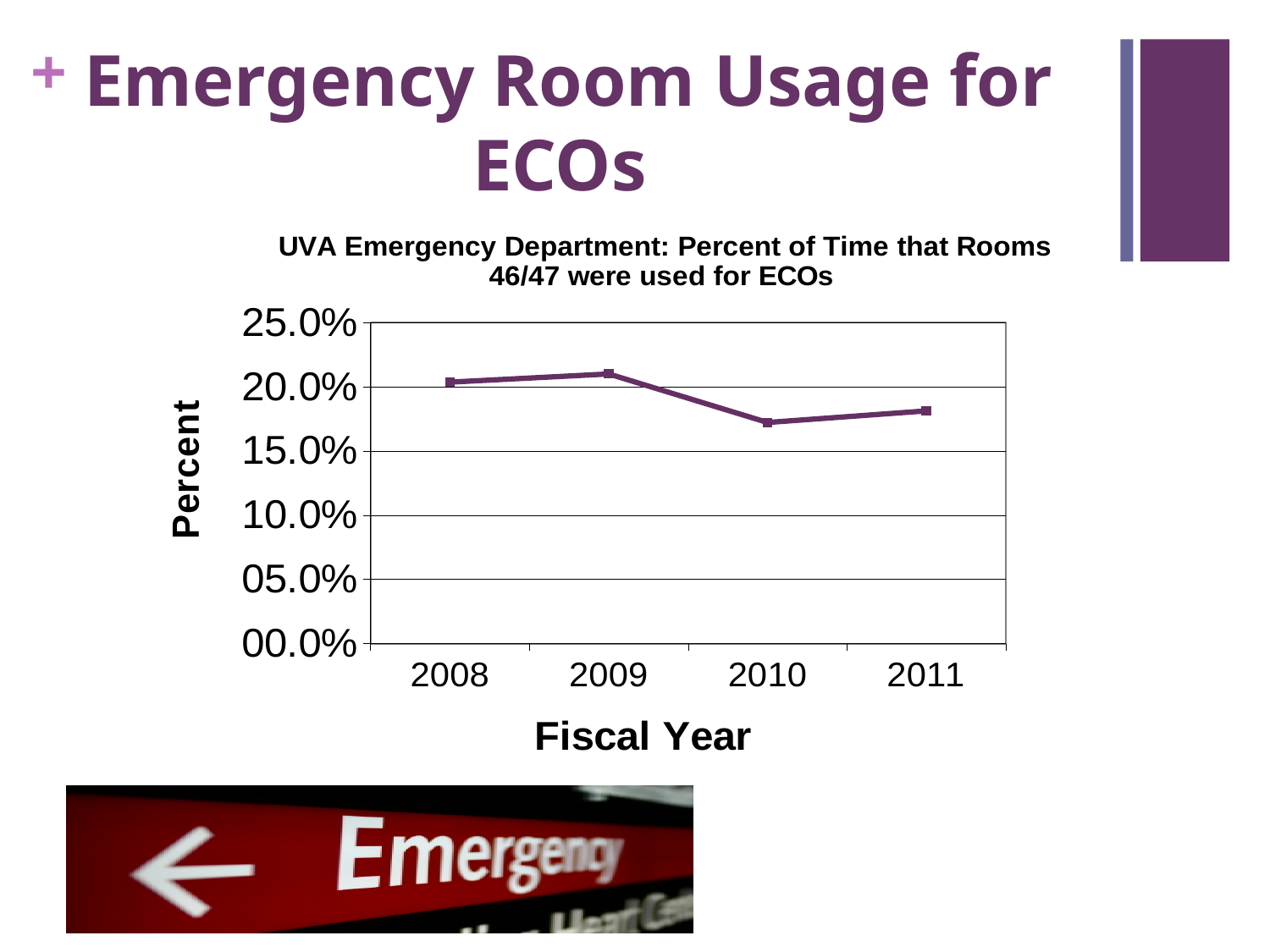
What kind of chart is shown on the slide? line chart Overall, does the percent rise or fall from 2008 to 2011? fall Is the value for 2011 greater or less than 20.0%? less How many fiscal years are plotted on the chart? 4 Which is larger, the value for 2009 or the value for 2010? 2009 Which fiscal year has the highest percent of time that rooms 46/47 were used for ECOs? 2009 Is the value for 2010 greater or less than 15.0%? greater Which is larger, the value for 2008 or the value for 2011? 2008 Is the value for 2010 greater or less than 20.0%? less Which fiscal year has the lowest percent of time that rooms 46/47 were used for ECOs? 2010 What is the label on the x axis of the chart? Fiscal Year